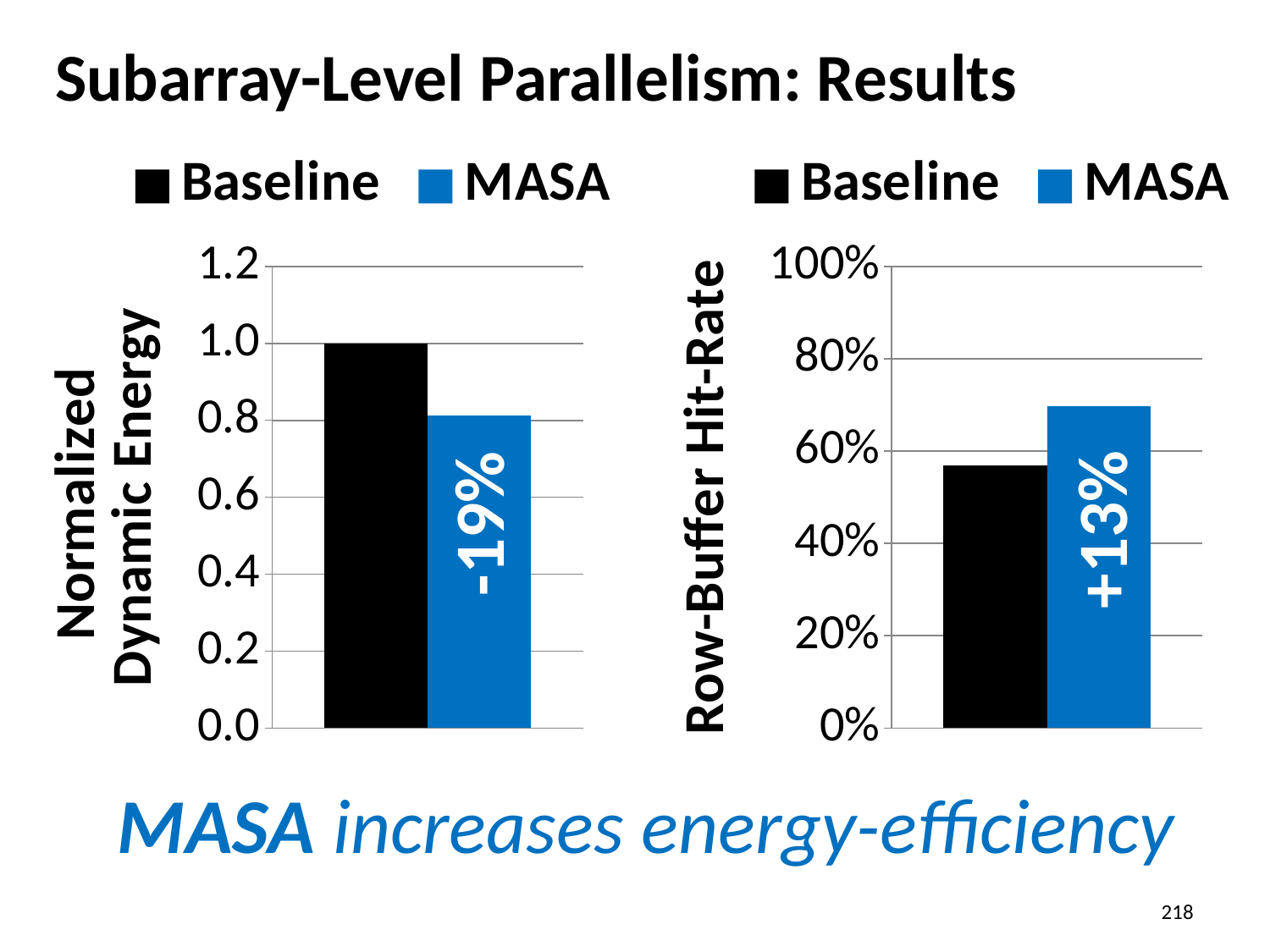
In the Row-Buffer Hit-Rate chart on the right, what percentage change is printed on the MASA bar? +13% In the Row-Buffer Hit-Rate chart on the right, which series has the higher value, Baseline or MASA? MASA In the Normalized Dynamic Energy chart on the left, which series has the lower value, Baseline or MASA? MASA In the Normalized Dynamic Energy chart on the left, what is the value for Baseline? 1.0 In the Normalized Dynamic Energy chart on the left, is the value for MASA greater or less than 1.0? less In the Normalized Dynamic Energy chart on the left, what percentage change is printed on the MASA bar? -19% In the Row-Buffer Hit-Rate chart on the right, is the value for Baseline greater or less than 60%? less In the Normalized Dynamic Energy chart on the left, what kind of chart is shown? bar chart In the Row-Buffer Hit-Rate chart on the right, how many bars are plotted? 2 In the Row-Buffer Hit-Rate chart on the right, what kind of chart is shown? bar chart In the Row-Buffer Hit-Rate chart on the right, is the value for MASA greater or less than 60%? greater In the Normalized Dynamic Energy chart on the left, how many series does the legend list? 2